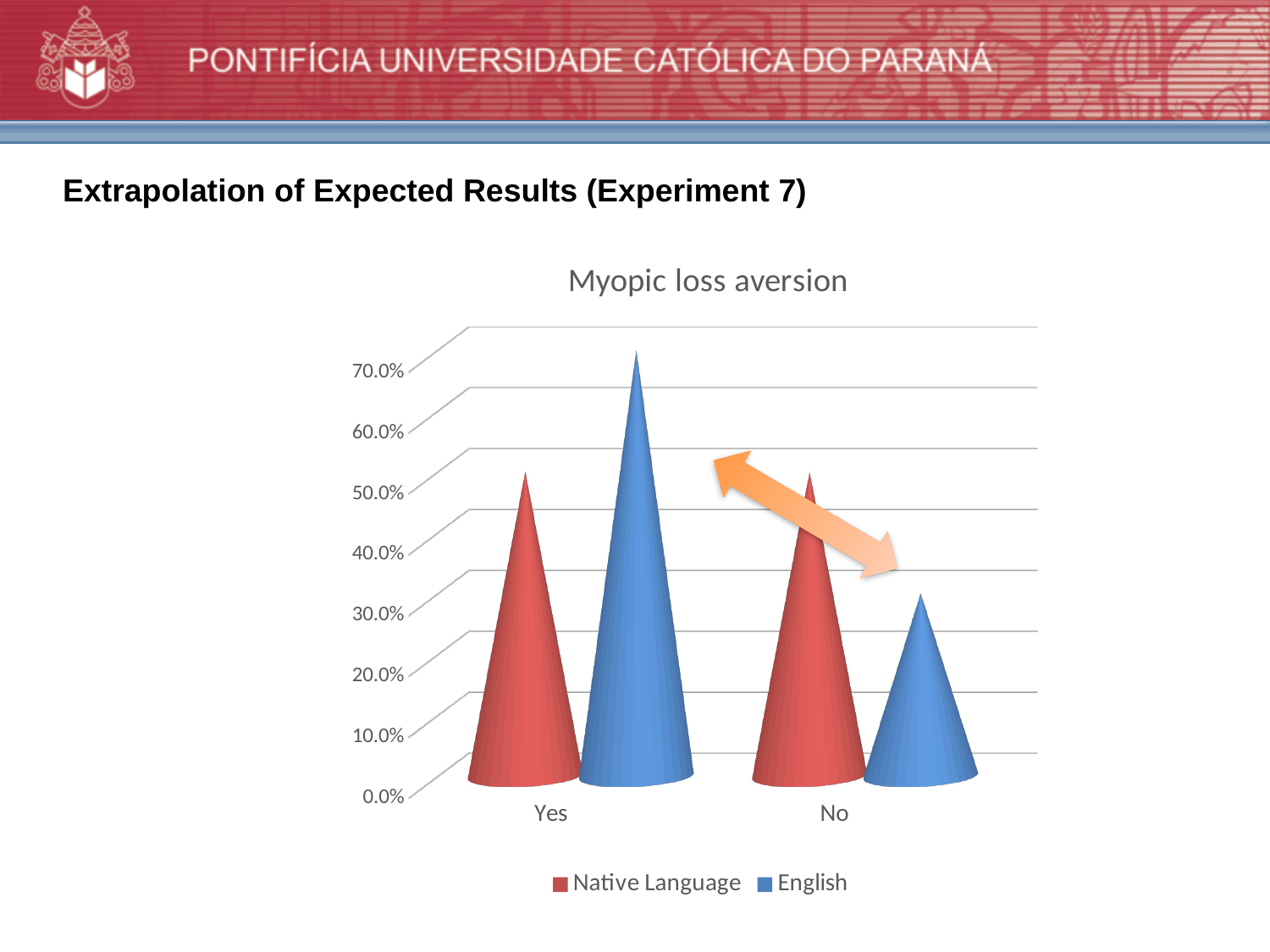
In the No category, which series has the larger value, Native Language or English? Native Language How many series does the legend list? 2 Which series is shown in blue? English Is the value for Native Language in the Yes category greater or less than 30.0%? greater Which bar is the highest in the chart? English, Yes In the Yes category, which series has the larger value, Native Language or English? English How many categories are shown on the x axis? 2 Is the value for English in the No category greater or less than 50.0%? less What is the title of the chart? Myopic loss aversion Is the value for English in the Yes category greater or less than 60.0%? greater What type of chart is shown on the slide? bar chart Which bar is the lowest in the chart? English, No